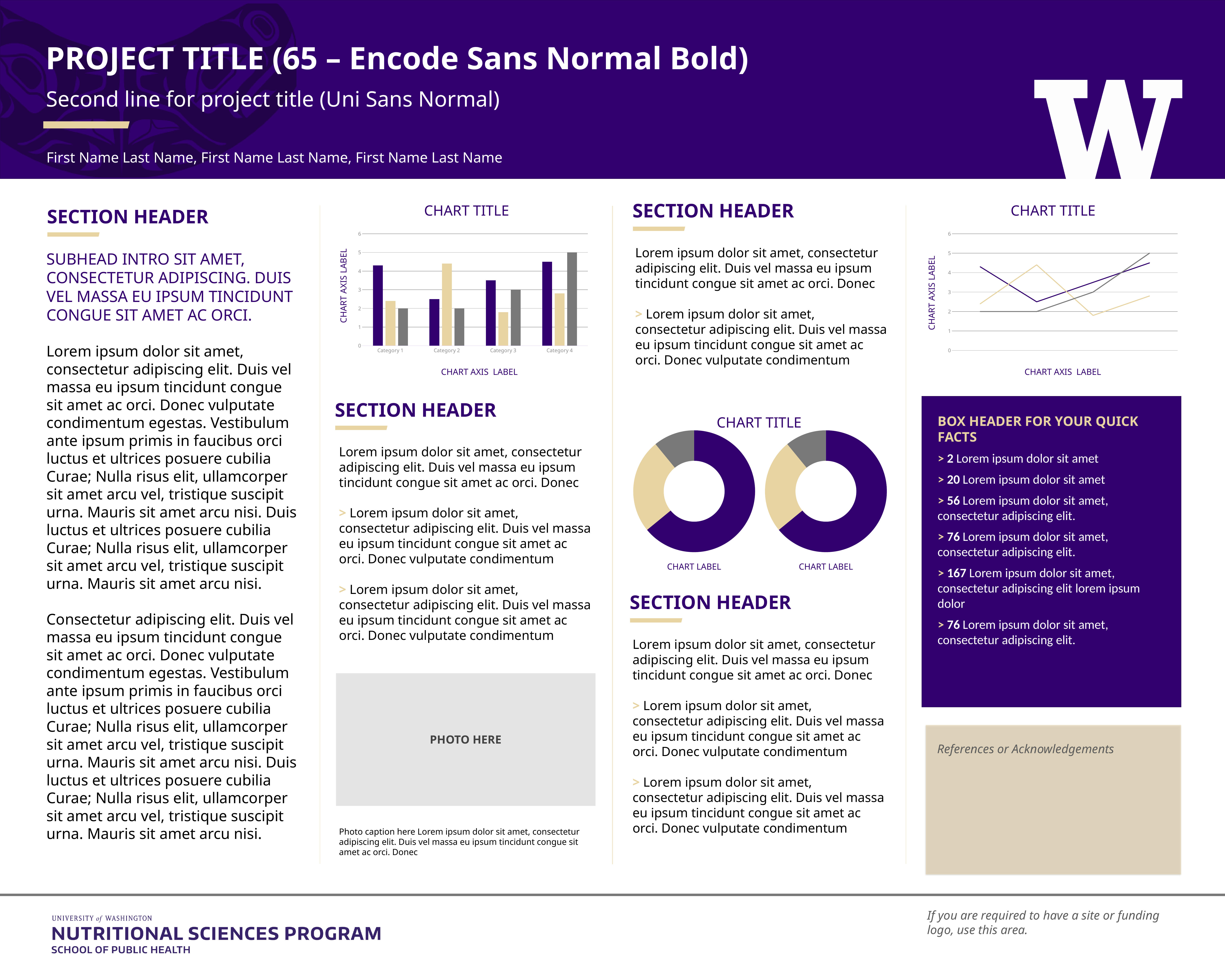
In the bar chart in the upper middle-left of the slide, is the value of the purple bar for Category 2 greater or less than 3? less In the bar chart in the upper middle-left of the slide, is the value of the purple bar for Category 1 greater or less than 4? greater In the bar chart in the upper middle-left of the slide, which category contains the tallest bar? Category 4 In the bar chart in the upper middle-left of the slide, what is the label of the first category on the x axis? Category 1 In the line chart in the upper right of the slide, does the gray line rise or fall from its first point to its last point? rise What kind of chart is the chart titled CHART TITLE in the upper middle-left of the slide, next to the first SECTION HEADER? bar chart In the bar chart in the upper middle-left of the slide, what is the highest tick value shown on the vertical axis? 6 What kind of charts are the two charts in the centre of the slide labelled CHART LABEL? doughnut charts In the bar chart in the upper middle-left of the slide, is the tan bar for Category 2 taller or shorter than the tan bar for Category 3? taller What kind of chart is the chart titled CHART TITLE in the upper right of the slide? line chart In the bar chart in the upper middle-left of the slide, how many categories are shown on the x axis? 4 In the line chart in the upper right of the slide, is the last point of the purple line greater or less than 4? greater